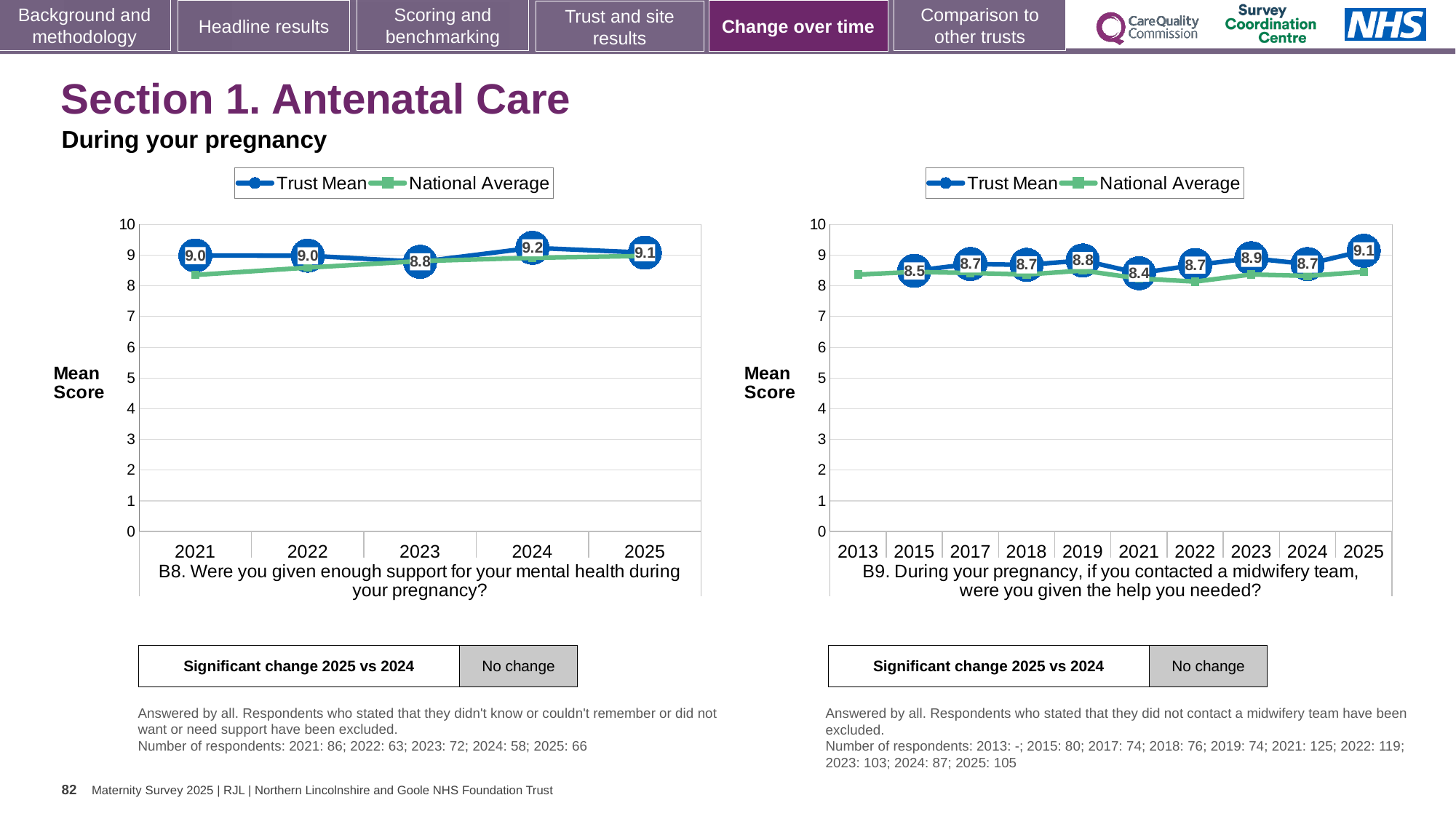
In the B8 chart (left), which year has the lowest Trust Mean? 2023 In the B8 chart (left), what is the difference between the Trust Mean for 2024 and 2023? 0.4 In the B9 chart (right), which year has the lowest labelled Trust Mean? 2021 In the B9 chart (right), what is the Trust Mean for 2021? 8.4 In the B8 chart (left), how many years are shown on the x axis? 5 In the B9 chart (right), what is the Trust Mean for 2025? 9.1 In the B8 chart (left), which year has the highest Trust Mean? 2024 In the B9 chart (right), is the National Average for 2013 greater or less than 9? less In the B8 chart (left), what is the Trust Mean for 2023? 8.8 How many series does the legend of the B9 chart (right) list? 2 In the B9 chart (right), is the Trust Mean higher in 2023 or 2024? 2023 In the B8 chart (left), what is the Trust Mean for 2024? 9.2